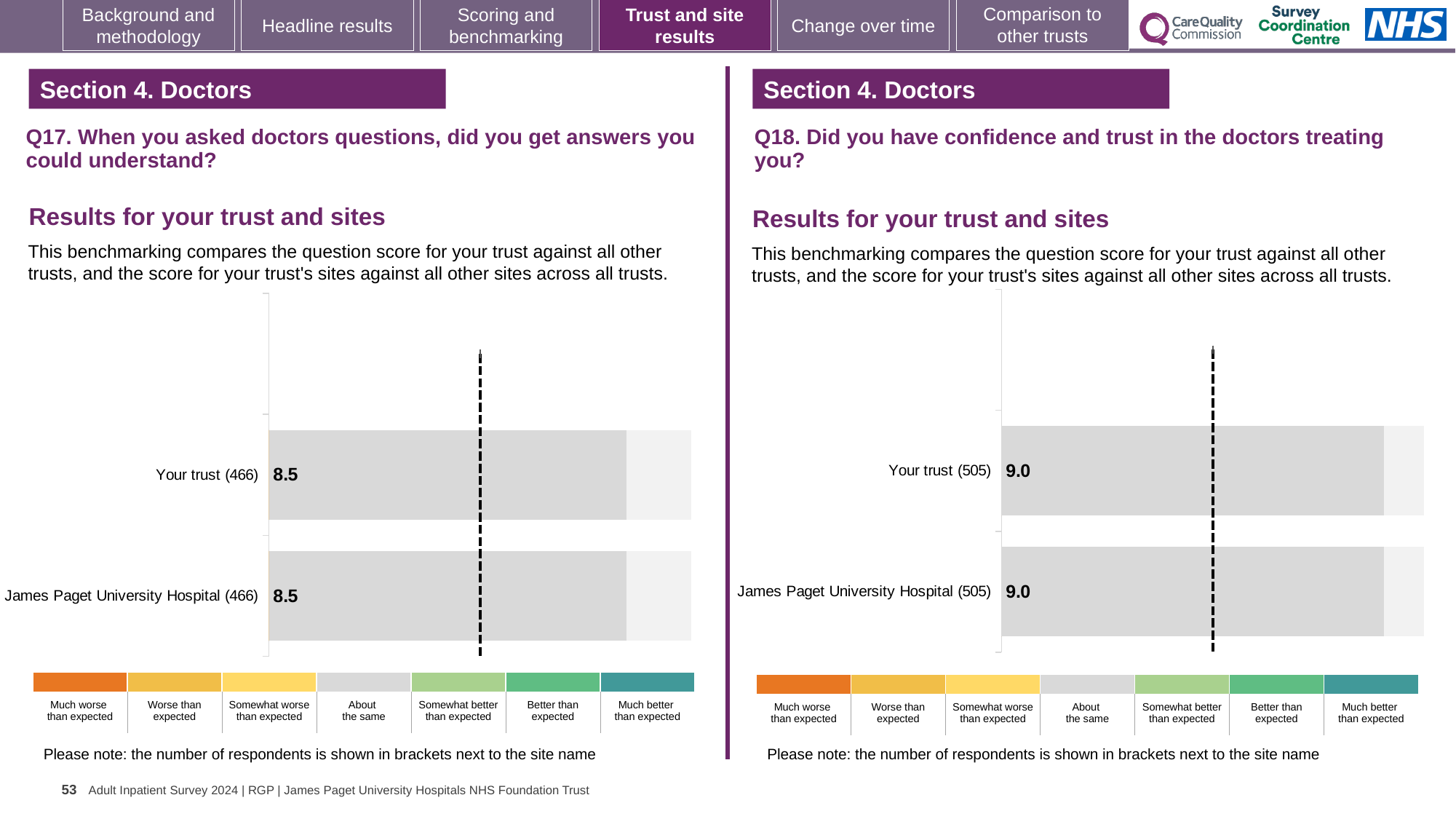
What type of chart is used for the Q17 results (left)? Bar chart How many bars are plotted on the Q17 chart (left)? 2 On the Q17 chart (left), what is the difference between the score for Your trust and the score for James Paget University Hospital? 0.0 On the Q18 chart (right), what is the score for James Paget University Hospital? 9.0 How many bars are plotted on the Q18 chart (right)? 2 Is the score for Your trust on the Q18 chart (right) larger or smaller than the score for Your trust on the Q17 chart (left)? Larger On the Q18 chart (right), what is the score for Your trust? 9.0 On the Q18 chart (right), what is the difference between the score for Your trust and the score for James Paget University Hospital? 0.0 On the Q17 chart (left), what is the score for Your trust? 8.5 On the Q18 chart (right), how many respondents are shown in brackets next to James Paget University Hospital? 505 On the Q17 chart (left), how many respondents are shown in brackets next to Your trust? 466 On the Q17 chart (left), what is the score for James Paget University Hospital? 8.5